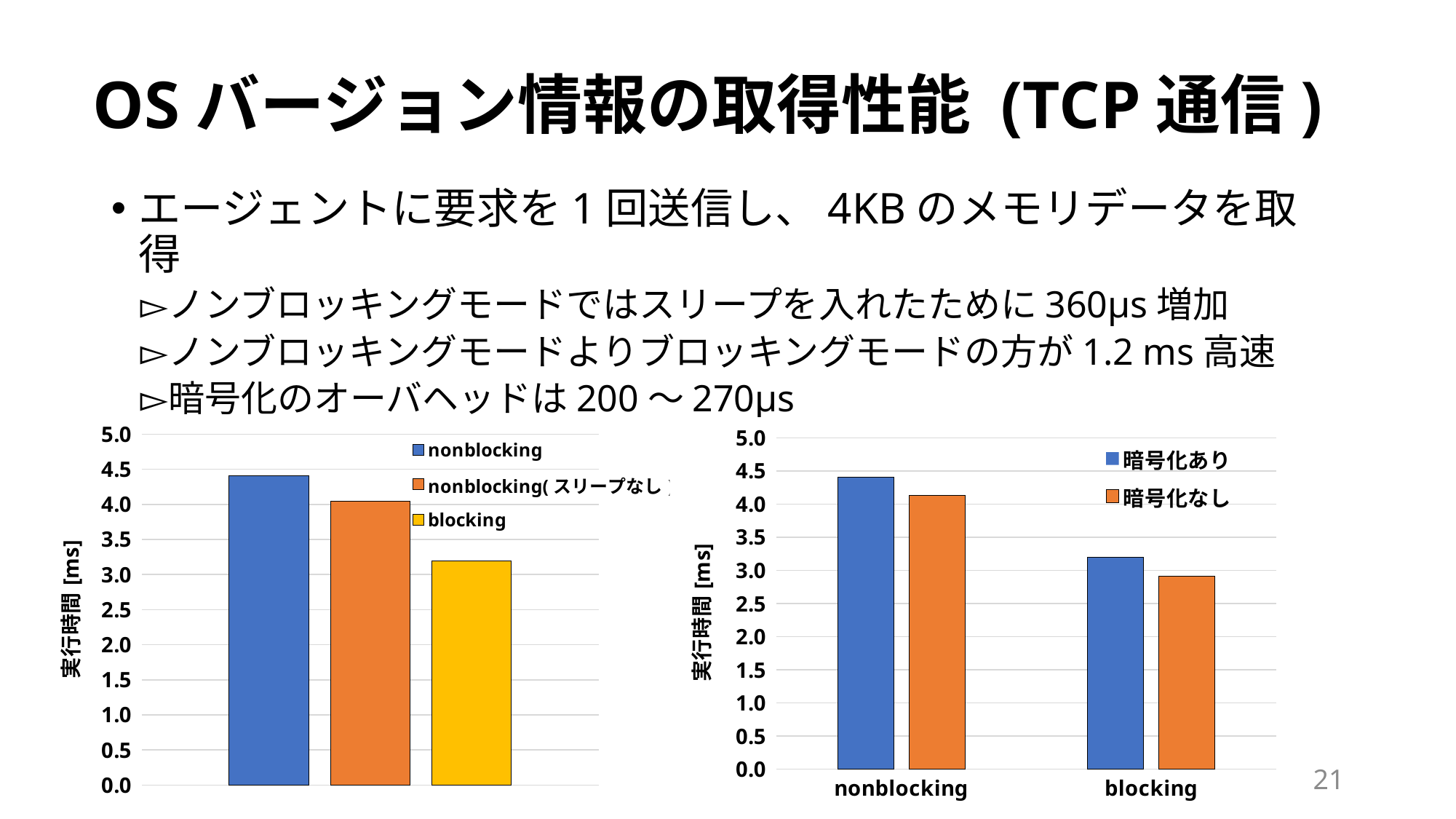
What kind of chart is the left chart on the slide? bar chart In the left chart, which series has the highest value? nonblocking In the left chart, which series has the lowest value? blocking In the right chart, which is larger for nonblocking: 暗号化あり or 暗号化なし? 暗号化あり In the left chart, is the value for blocking greater or less than 3.5? less What is the y-axis label of the right chart? 実行時間 [ms] In the left chart, is the value for nonblocking greater or less than 4.0? greater How many series does the legend of the right chart list? 2 In the left chart, which is larger: nonblocking or nonblocking(スリープなし)? nonblocking How many series does the legend of the left chart list? 3 How many categories are shown on the x axis of the right chart? 2